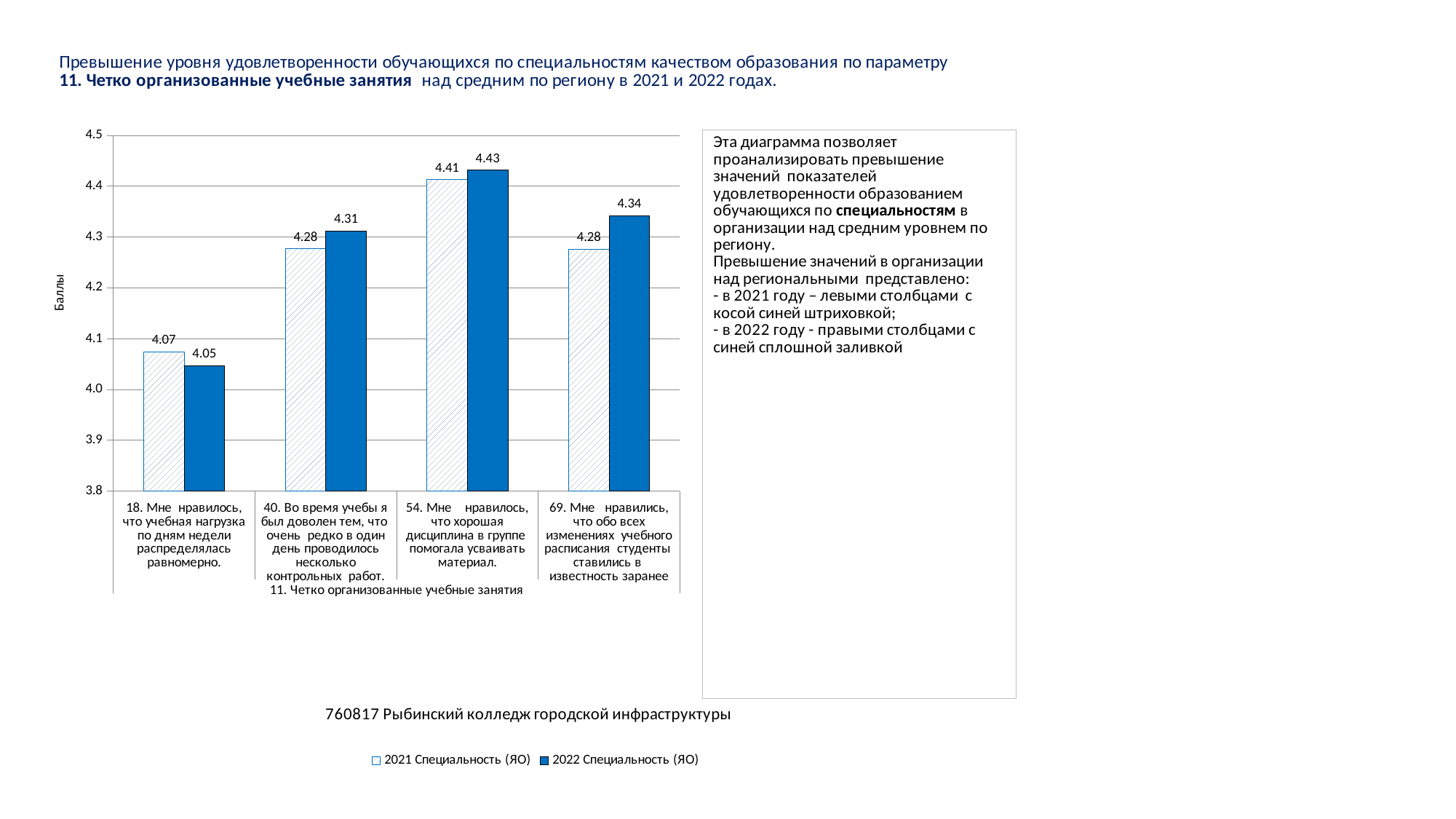
What is the 2021 Специальность (ЯО) value for category 18 (Мне нравилось, что учебная нагрузка по дням недели распределялась равномерно)? 4.07 What is the 2022 Специальность (ЯО) value for category 54 (Мне нравилось, что хорошая дисциплина в группе помогала усваивать материал)? 4.43 What kind of chart is shown on the slide? bar chart How many categories are shown on the x axis? 4 What is the 2022 Специальность (ЯО) value for category 69 (Мне нравились, что обо всех изменениях учебного расписания студенты ставились в известность заранее)? 4.34 For category 18, which is larger: the 2021 value or the 2022 value? 2021 Which category has the lowest 2022 Специальность (ЯО) value? 18. Мне нравилось, что учебная нагрузка по дням недели распределялась равномерно. Is the 2021 value for category 40 greater or less than 4.2? greater What is the difference between the 2022 and 2021 values for category 69? 0.06 Which category has the highest 2021 Специальность (ЯО) value? 54. Мне нравилось, что хорошая дисциплина в группе помогала усваивать материал. What is the difference between the 2022 and 2021 values for category 40? 0.03 How many series does the legend list? 2